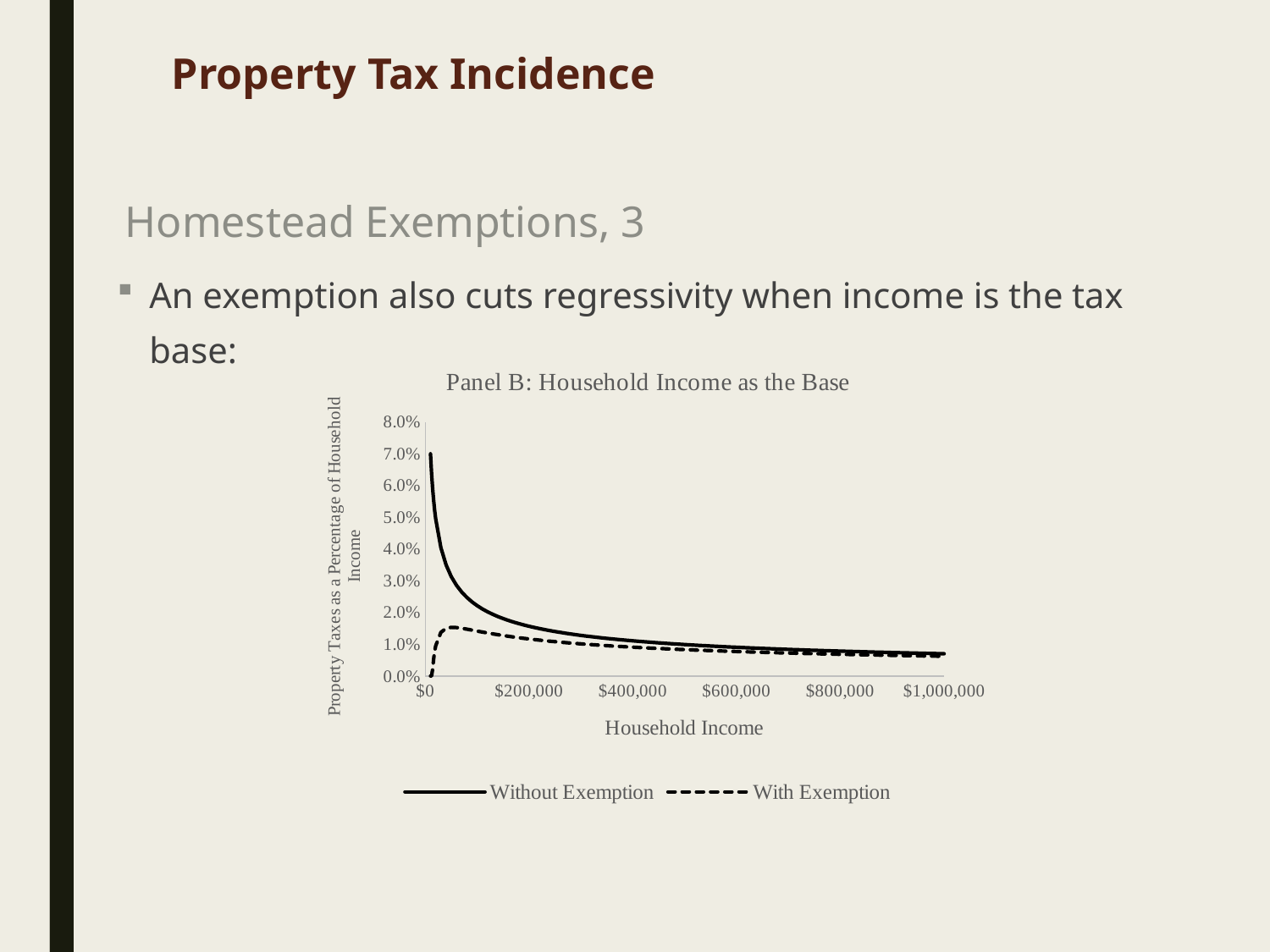
At a household income of $200,000, which line is higher: Without Exemption or With Exemption? Without Exemption What is the title of the chart? Panel B: Household Income as the Base Is the value of the Without Exemption line at $1,000,000 greater or less than 1.0%? less What is the label of the x axis of the chart? Household Income Is the highest value reached by the With Exemption line greater or less than 2.0%? less Which series is drawn with a dashed line? With Exemption Does the Without Exemption line rise or fall as household income increases? fall What kind of chart is shown on the slide? line chart How many series does the chart's legend list? 2 Is the starting value of the Without Exemption line near $0 greater or less than 6.0%? greater